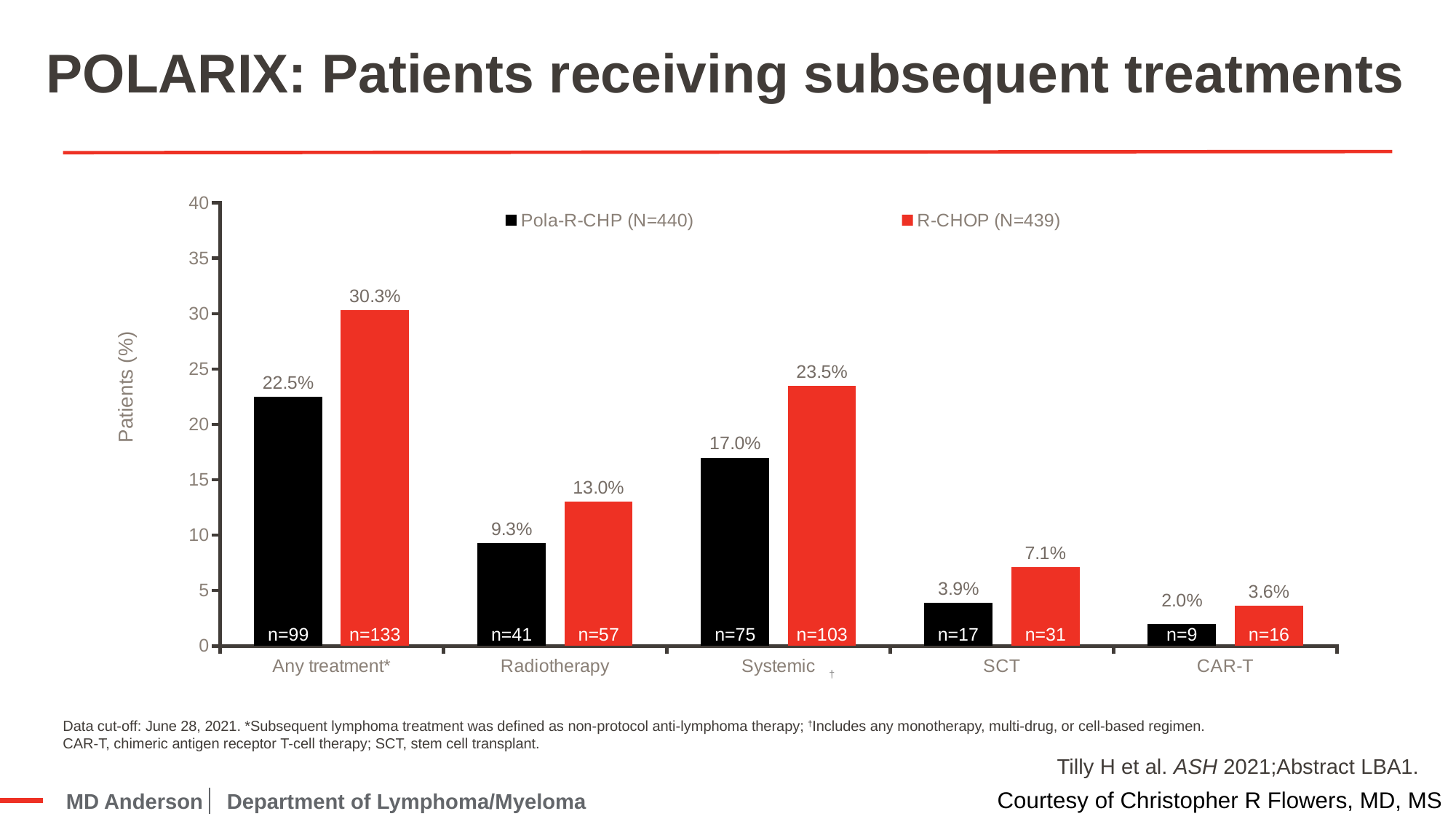
What percentage of Pola-R-CHP patients received any subsequent treatment? 22.5% What kind of chart is shown on the slide? Bar chart Which treatment category has the lowest value for Pola-R-CHP? CAR-T Which treatment category has the highest value for R-CHOP? Any treatment* What percentage of R-CHOP patients received subsequent radiotherapy? 13.0% Which arm has the larger percentage of patients receiving subsequent systemic treatment, Pola-R-CHP or R-CHOP? R-CHOP What percentage of Pola-R-CHP patients received CAR-T? 2.0% How many R-CHOP patients received subsequent systemic treatment (n)? n=103 What colour represents the R-CHOP (N=439) series? Red How many series does the legend list? 2 How many treatment categories are shown on the x axis? 5 What is the difference between the R-CHOP and Pola-R-CHP percentages for SCT? 3.2%